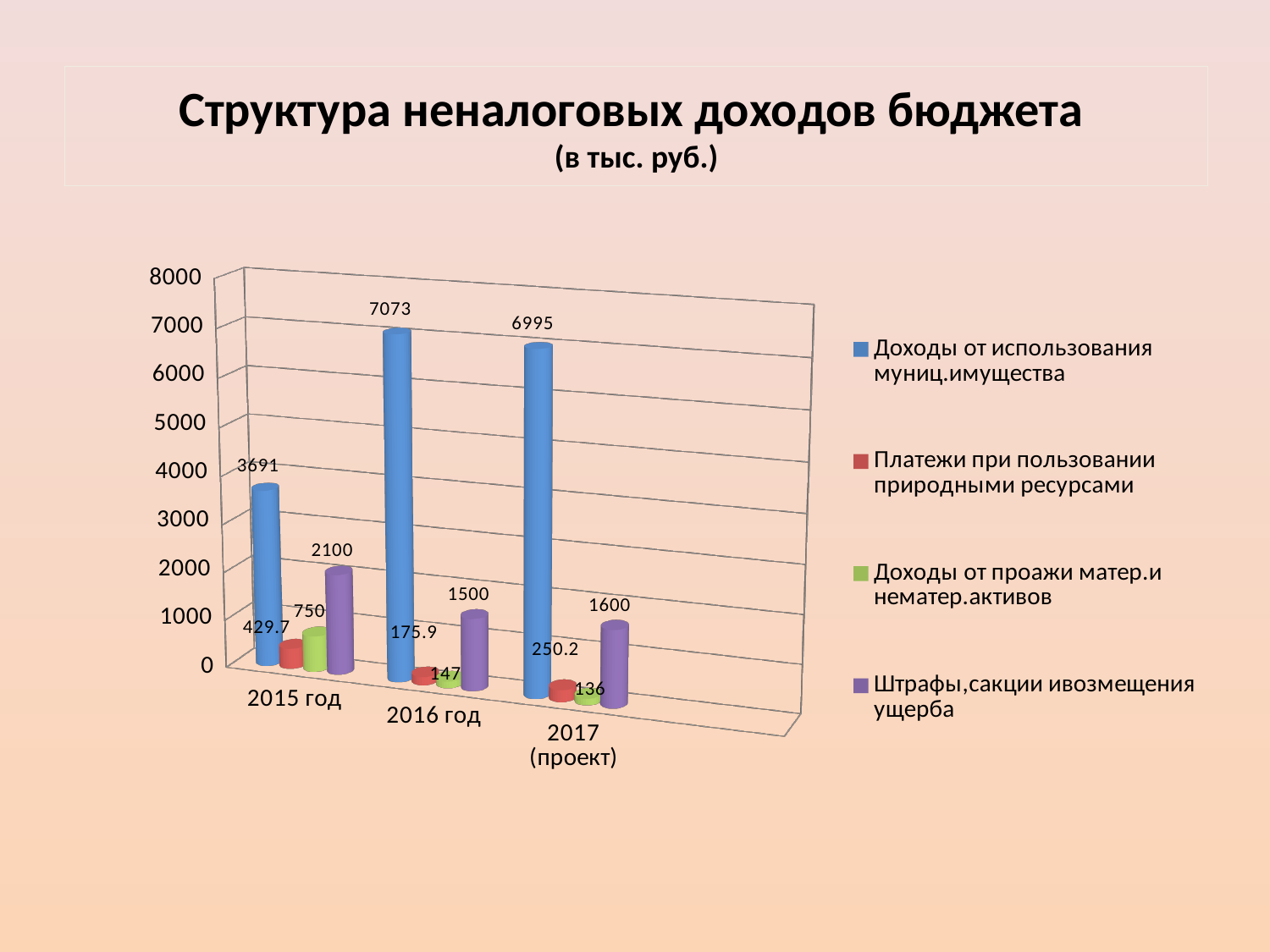
Which is larger: Штрафы,сакции ивозмещения ущерба in 2015 год or in 2016 год? 2015 год What is the value for Доходы от проажи матер.и нематер.активов in 2016 год? 147 In which year is the value for Доходы от использования муниц.имущества the highest? 2016 год What kind of chart is shown on the slide? Bar chart What is the value for Платежи при пользовании природными ресурсами in 2015 год? 429.7 What colour are the bars for Штрафы,сакции ивозмещения ущерба? Purple What is the value for Доходы от использования муниц.имущества in 2016 год? 7073 In which year is the value for Доходы от проажи матер.и нематер.активов the lowest? 2017 (проект) What is the difference between the Доходы от использования муниц.имущества values for 2016 год and 2017 (проект)? 78 How many series does the legend list? 4 What is the value for Штрафы,сакции ивозмещения ущерба in 2017 (проект)? 1600 How many year categories are shown on the x axis? 3